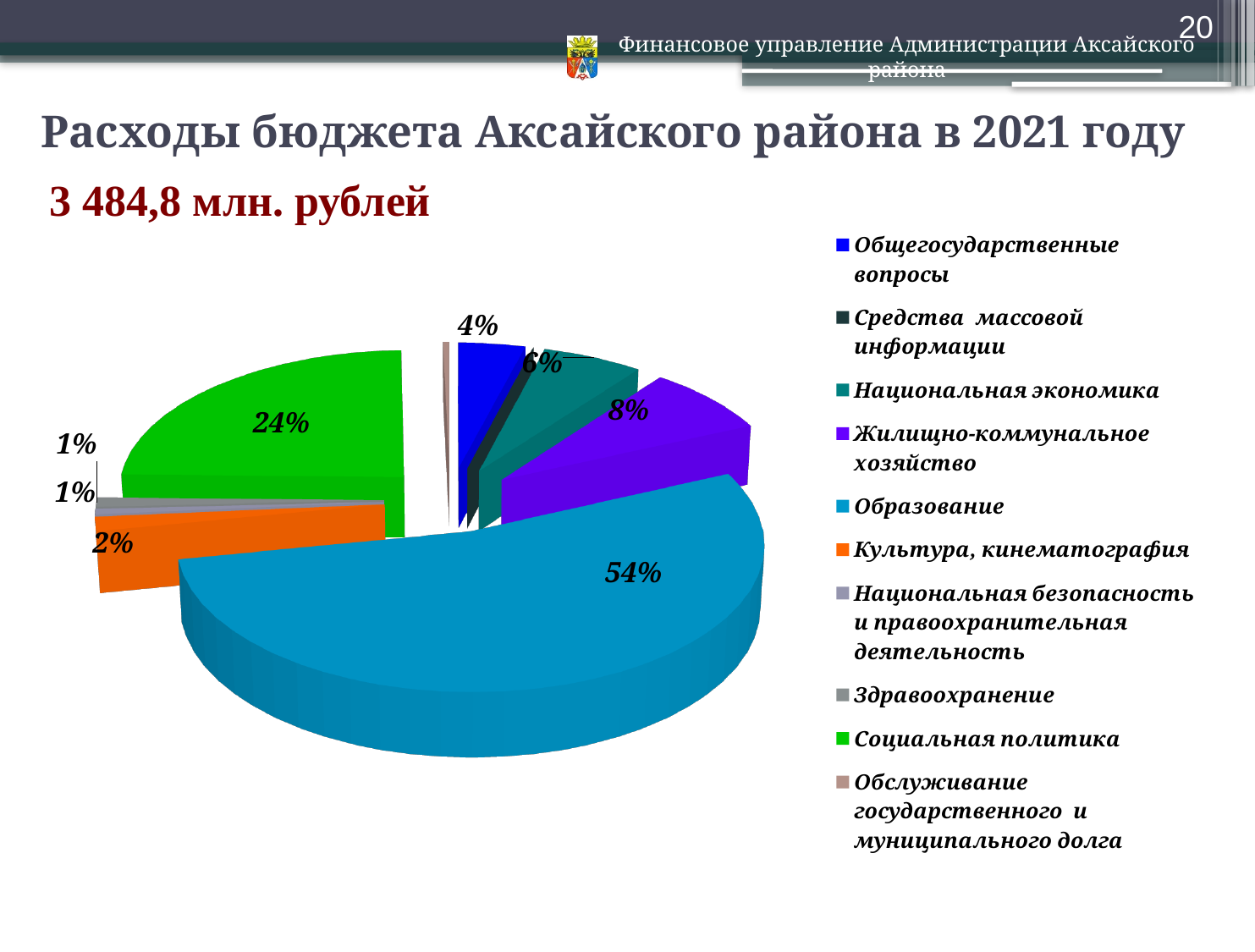
What is the difference in percentage points between Образование and Социальная политика? 30 Which category has the largest share of the pie? Образование Which is larger: the share for Социальная политика or for Жилищно-коммунальное хозяйство? Социальная политика What percentage is shown for Культура, кинематография? 2% What percentage is shown for Жилищно-коммунальное хозяйство? 8% What is the title of the chart on the slide? Расходы бюджета Аксайского района в 2021 году What share of the pie does Образование have? 54% How many categories does the legend list? 10 What total amount of expenditure is stated on the slide? 3 484,8 млн. рублей What percentage is shown for Общегосударственные вопросы? 4% What percentage is shown for Социальная политика? 24% What kind of chart is shown on the slide? Pie chart